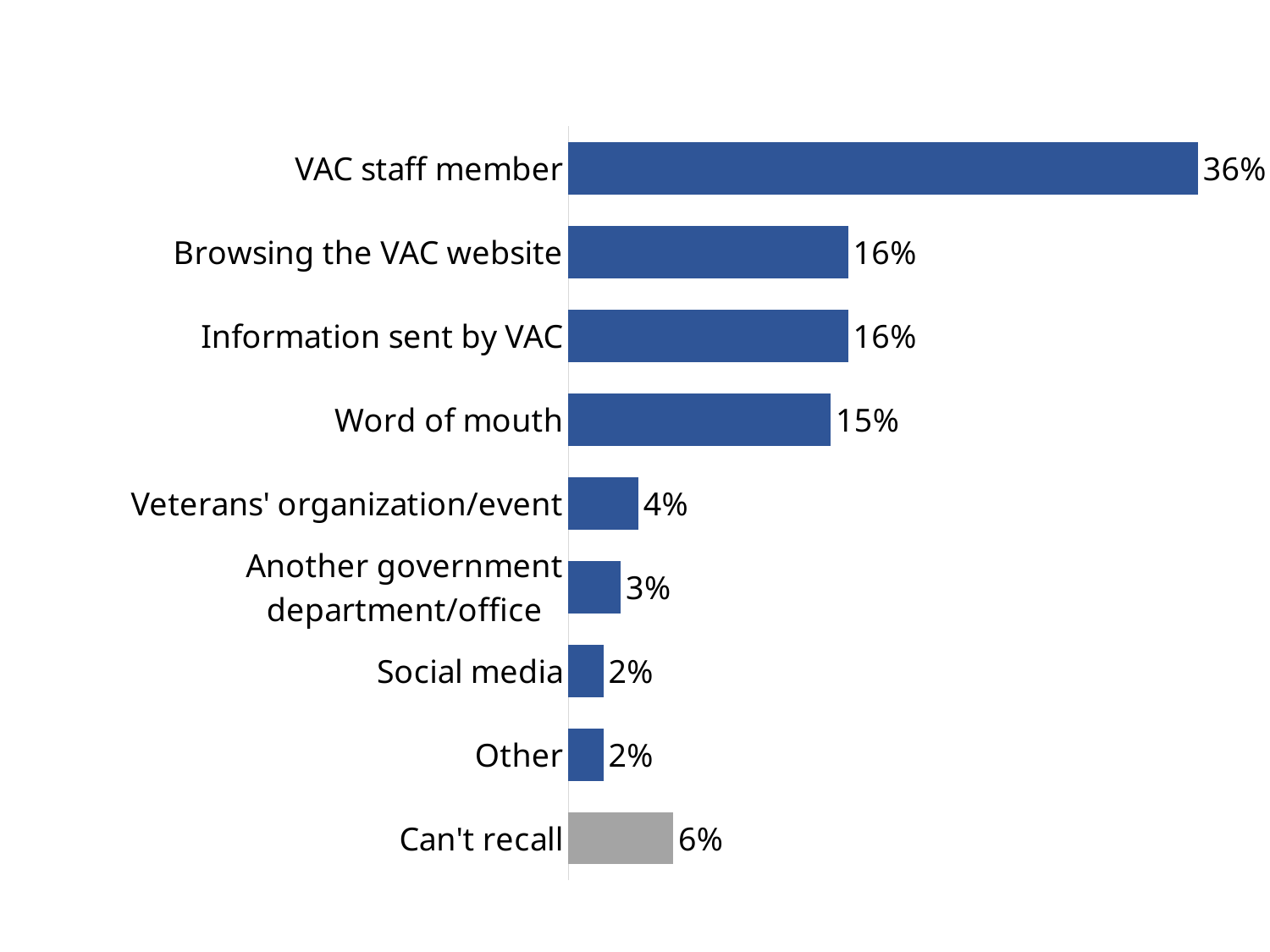
How many categories are shown in the chart? 9 Which is larger, the value for Can't recall or the value for Veterans' organization/event? Can't recall What is the value for Another government department/office? 3% Which bar is coloured grey rather than blue? Can't recall What is the value for Word of mouth? 15% What is the value for Can't recall? 6% What is the difference between the values for Word of mouth and Veterans' organization/event? 11% What is the difference between the values for VAC staff member and Browsing the VAC website? 20% What is the value for VAC staff member? 36% Which category has the highest value? VAC staff member What kind of chart is this? Bar chart Which is larger, the value for Information sent by VAC or the value for Word of mouth? Information sent by VAC